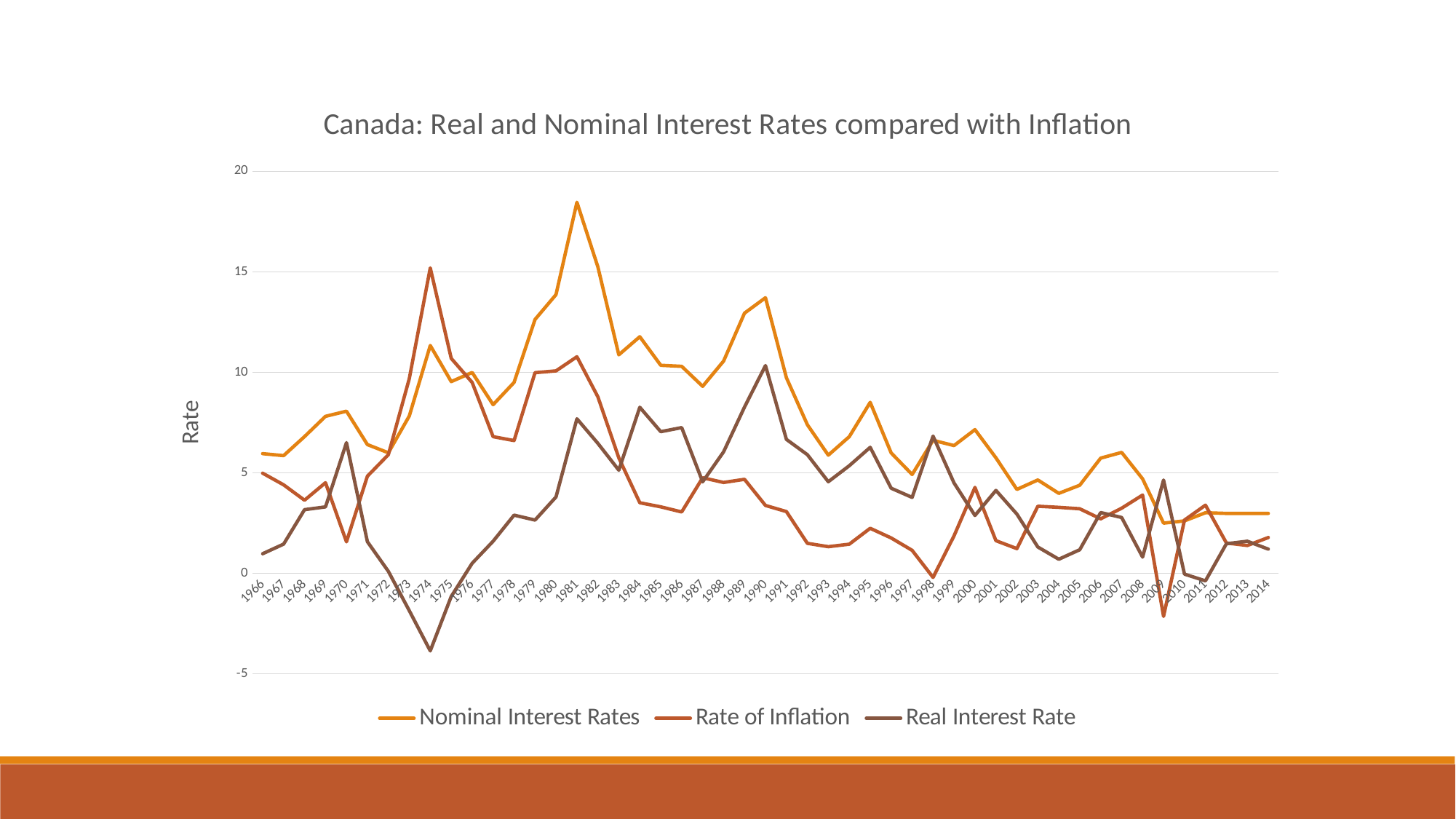
What is the title of the chart? Canada: Real and Nominal Interest Rates compared with Inflation How many series does the legend list? 3 In which year does the Rate of Inflation reach its highest value? 1974 How many years are plotted along the x axis? 49 Is the value for Nominal Interest Rates in 2014 greater or less than 5? less In which year do the Nominal Interest Rates reach their highest value? 1981 In 1974, which is larger: the Rate of Inflation or the Nominal Interest Rates? Rate of Inflation Is the value for Nominal Interest Rates in 1981 greater or less than 15? greater Do the Nominal Interest Rates generally rise or fall from 1981 to 2014? fall In which year is the Real Interest Rate at its lowest? 1974 What kind of chart is shown on the slide? line chart Is the value for Real Interest Rate in 1974 greater or less than 0? less